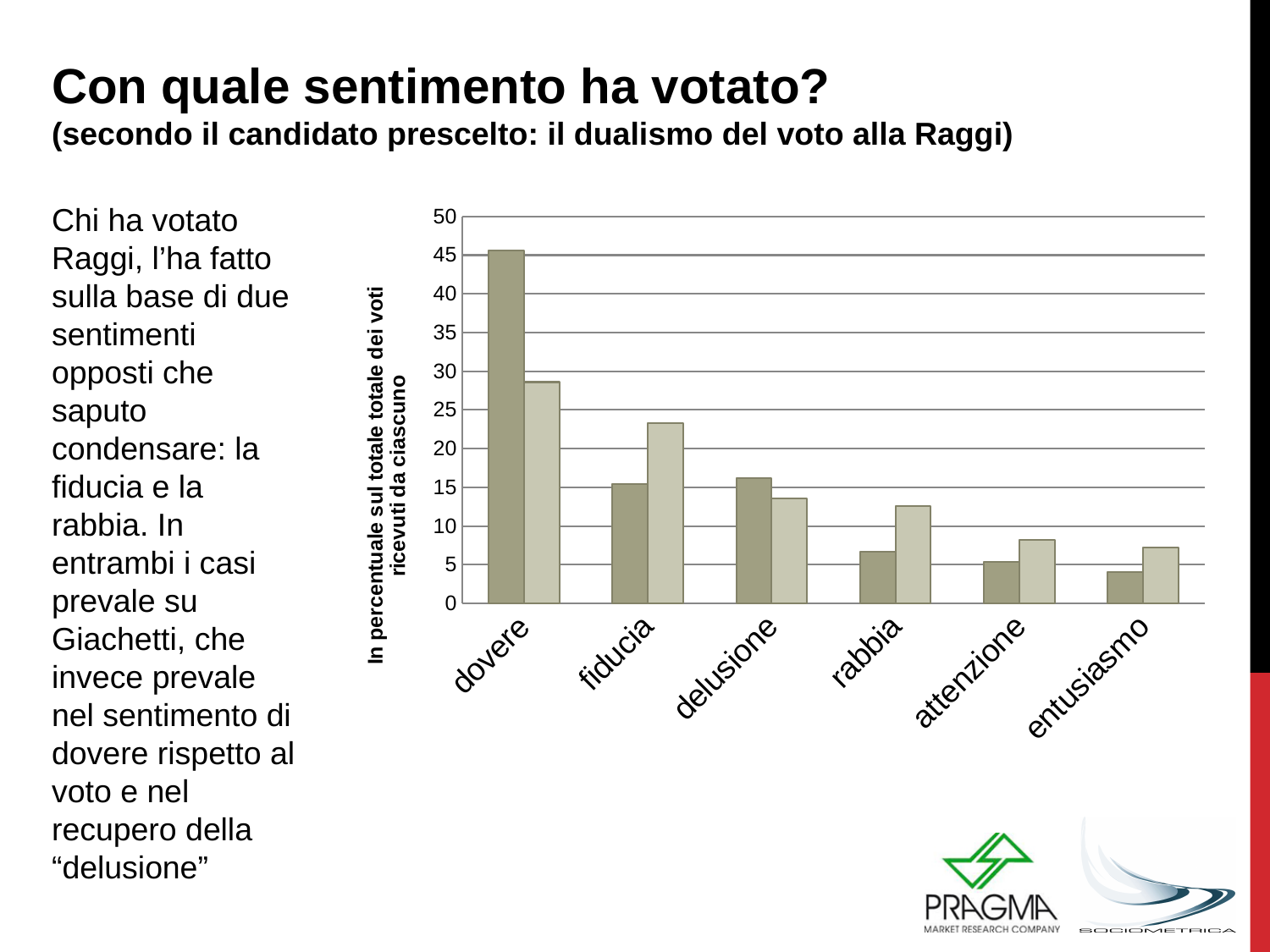
How many bars are plotted for each category in the chart? 2 Which category has the highest darker bar in the chart? dovere Is the darker bar for rabbia greater or less than 10? less Is the darker bar for dovere greater or less than 40? greater Do the lighter bars rise or fall from dovere to entusiasmo along the x axis? fall What kind of chart is shown on the slide? bar chart For fiducia, which bar is taller, the darker one or the lighter one? the lighter one Is the lighter bar for fiducia greater or less than 20? greater How many categories are shown on the x axis of the chart? 6 Which category has the lowest darker bar in the chart? entusiasmo What is the label of the vertical axis of the chart? In percentuale sul totale totale dei voti ricevuti da ciascuno Which category has the highest lighter bar in the chart? dovere